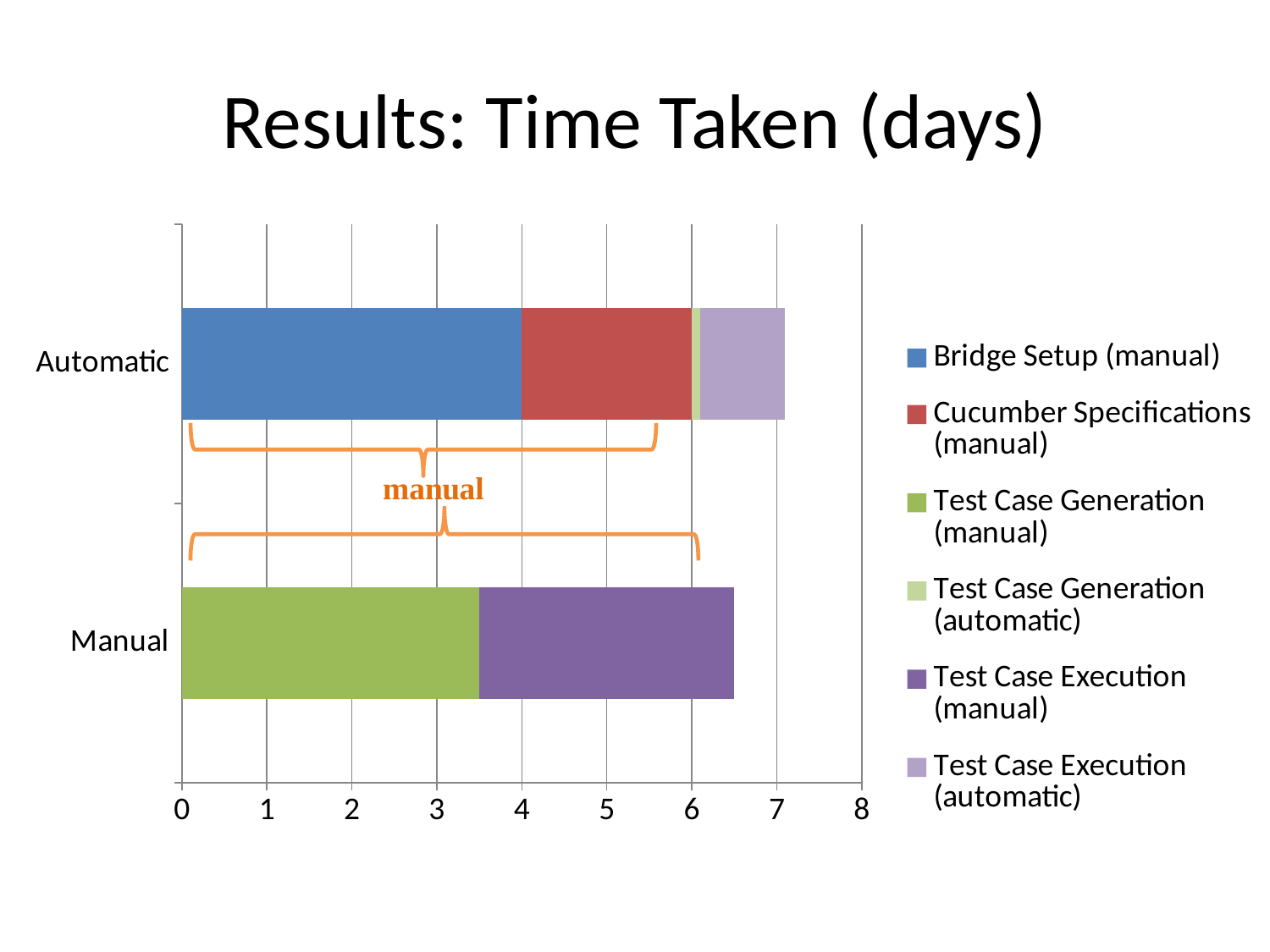
Which segment is the smallest in the Automatic bar? Test Case Generation (automatic) What is the title of the slide's chart? Results: Time Taken (days) Is the total length of the Automatic bar greater or less than 6? greater Which bar is longer in total, Automatic or Manual? Automatic How many series does the chart's legend list? 6 How many categories are shown on the vertical axis of the chart? 2 What kind of chart is shown on the slide? Stacked bar chart What colour represents Bridge Setup (manual) in the chart? Blue Is the total length of the Manual bar greater or less than 7? less What is the value of the Bridge Setup (manual) segment in the Automatic bar? 4 Is the Test Case Execution (manual) segment in the Manual bar greater or less than 2? greater